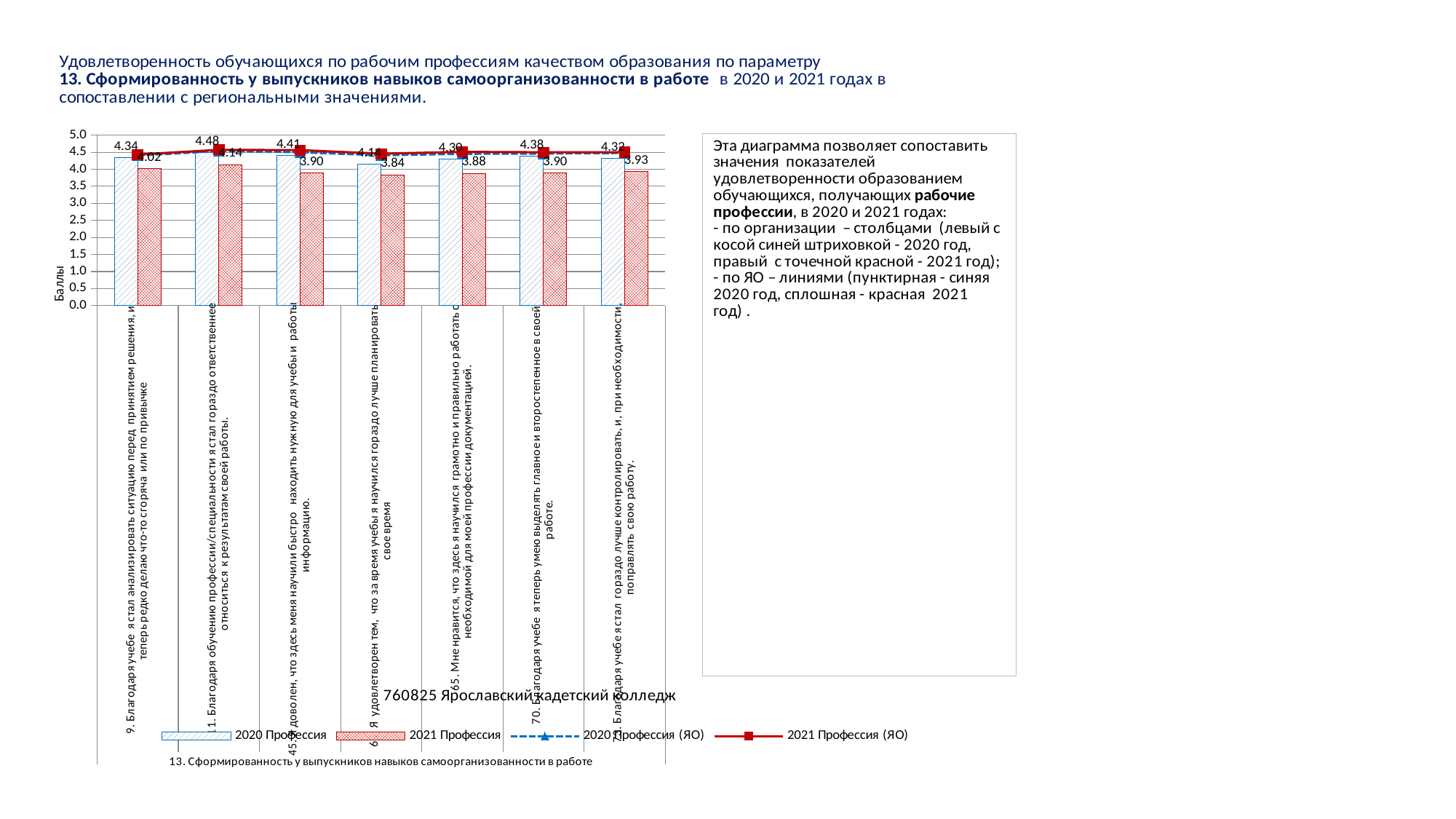
What is the label of the vertical axis of the chart? Баллы How many series does the chart legend list? 4 How many categories are shown on the x axis of the chart? 7 What is the value of the 2020 Профессия bar for category "11. Благодаря обучению профессии/специальности я стал гораздо ответственнее относиться к результатам своей работы"? 4.48 Which category has the lowest 2021 Профессия value? Я удовлетворен тем, что за время учебы я научился гораздо лучше планировать свое время What is the value of the 2021 Профессия bar for category "73. Благодаря учебе я стал гораздо лучше контролировать, и, при необходимости, поправлять свою работу"? 3.93 Which category has the highest 2020 Профессия value? 11. Благодаря обучению профессии/специальности я стал гораздо ответственнее относиться к результатам своей работы Is the 2021 Профессия value for category 65 greater or less than 4.0? less For category "70. Благодаря учебе я теперь умею выделять главное и второстепенное в своей работе", which is larger: the 2020 Профессия bar or the 2021 Профессия bar? 2020 Профессия What is the value of the 2021 Профессия bar for category "9. Благодаря учебе я стал анализировать ситуацию перед принятием решения..."? 4.02 What is the difference between the 2020 Профессия and 2021 Профессия values for category 11 (4.48 and 4.14)? 0.34 What is the difference between the 2020 Профессия and 2021 Профессия values for category "45. Я доволен, что здесь меня научили быстро находить нужную для учебы и работы информацию"? 0.51